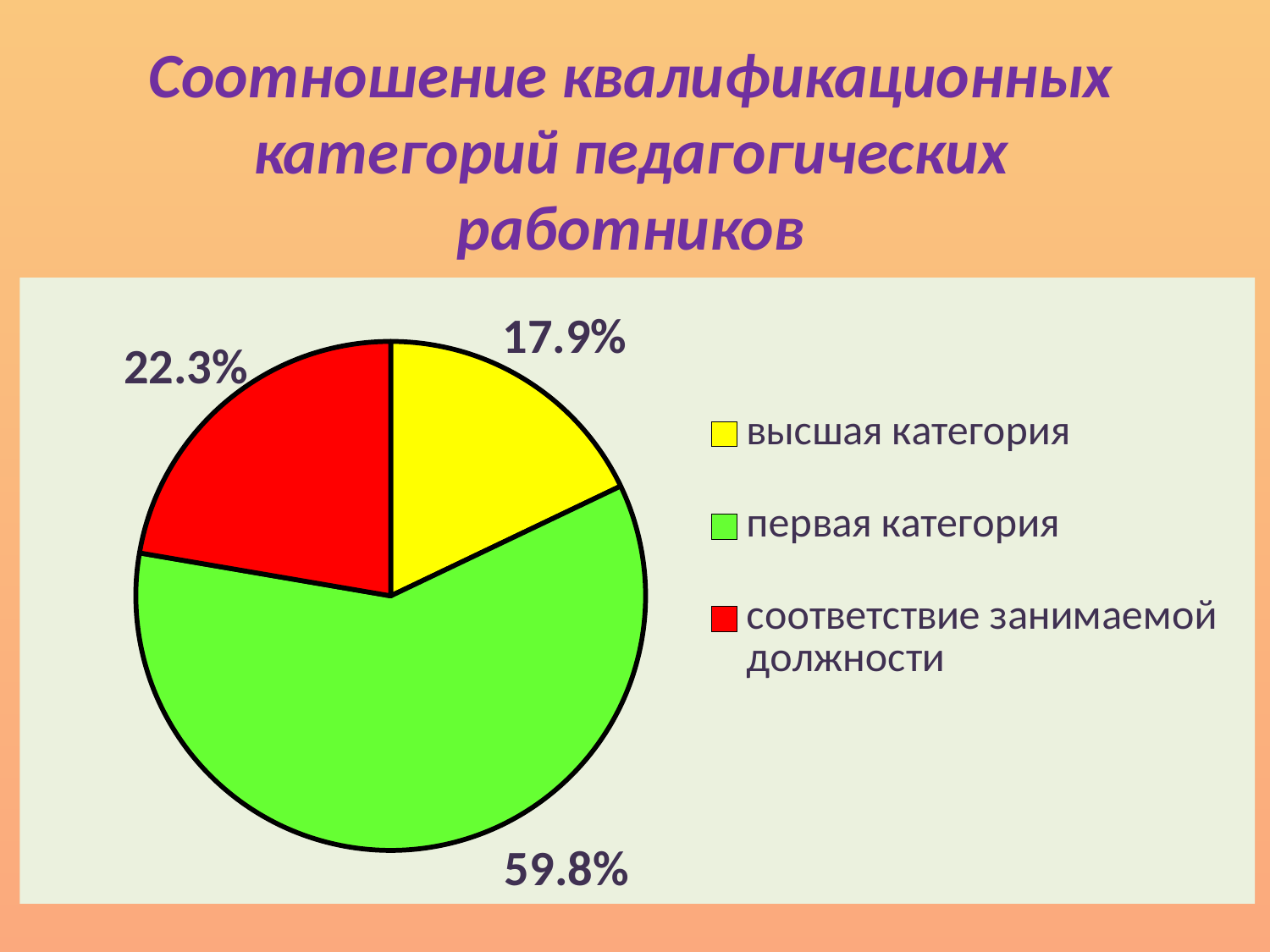
What is the title of the slide? Соотношение квалификационных категорий педагогических работников Which category has the smallest slice of the pie? высшая категория What share of the pie does "высшая категория" have? 17.9% What share of the pie does "первая категория" have? 59.8% What is the difference in percentage points between "соответствие занимаемой должности" and "высшая категория"? 4.4 What share of the pie does "соответствие занимаемой должности" have? 22.3% How many slices does the pie chart have? 3 What colour is the slice for "первая категория"? green What kind of chart is shown on the slide? pie chart Which is larger: the slice for "высшая категория" or the slice for "соответствие занимаемой должности"? соответствие занимаемой должности What is the difference in percentage points between "первая категория" and "соответствие занимаемой должности"? 37.5 Which category has the largest slice of the pie? первая категория